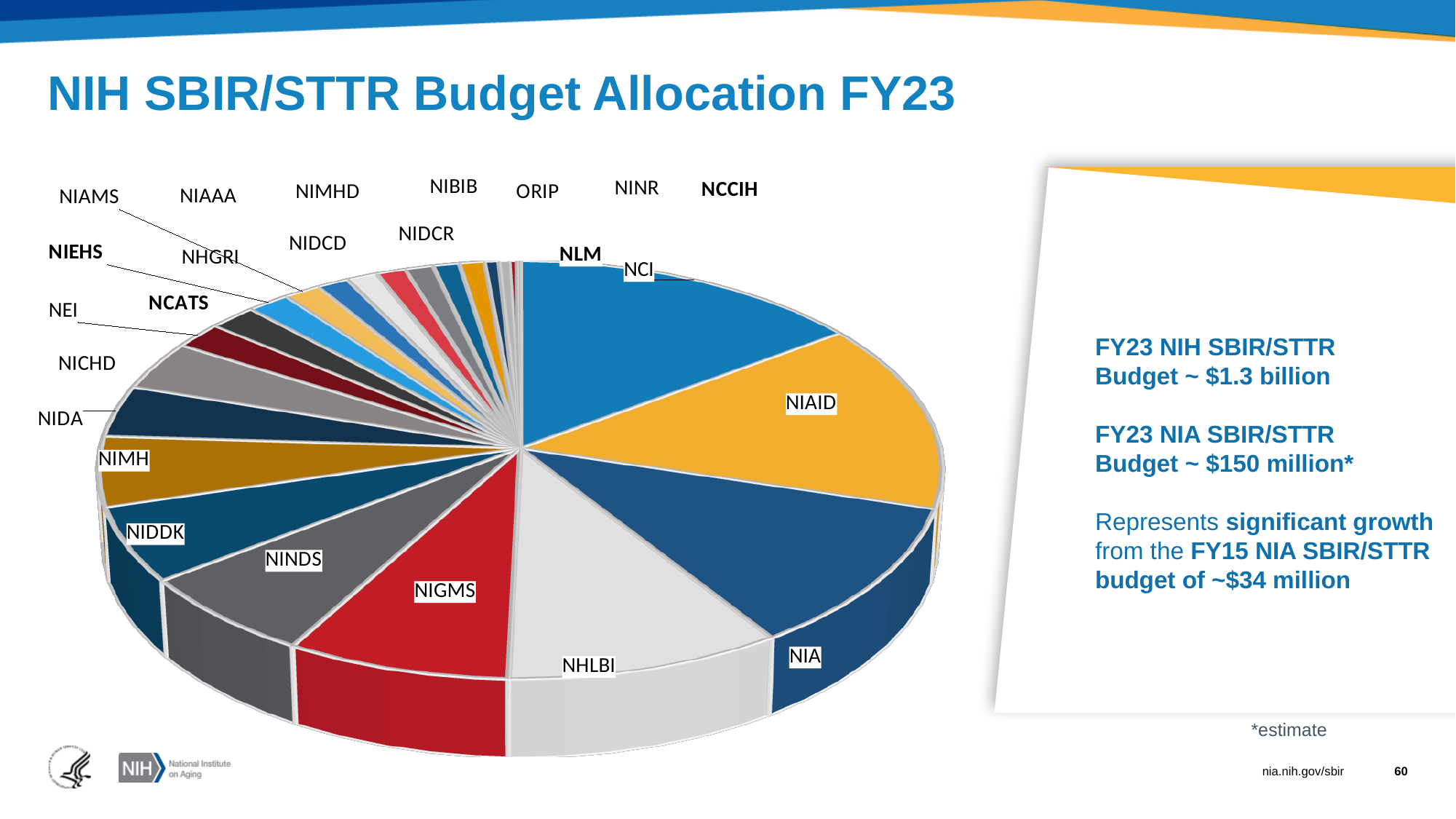
Which slice is larger in the pie chart, NCI or NIMH? NCI What is the title of the chart on the slide? NIH SBIR/STTR Budget Allocation FY23 Which slice is larger in the pie chart, NHLBI or NIDA? NHLBI Which slice is larger in the pie chart, NIGMS or NIDDK? NIGMS What colour is the NIAID slice in the pie chart? yellow What kind of chart is shown on the slide? pie chart